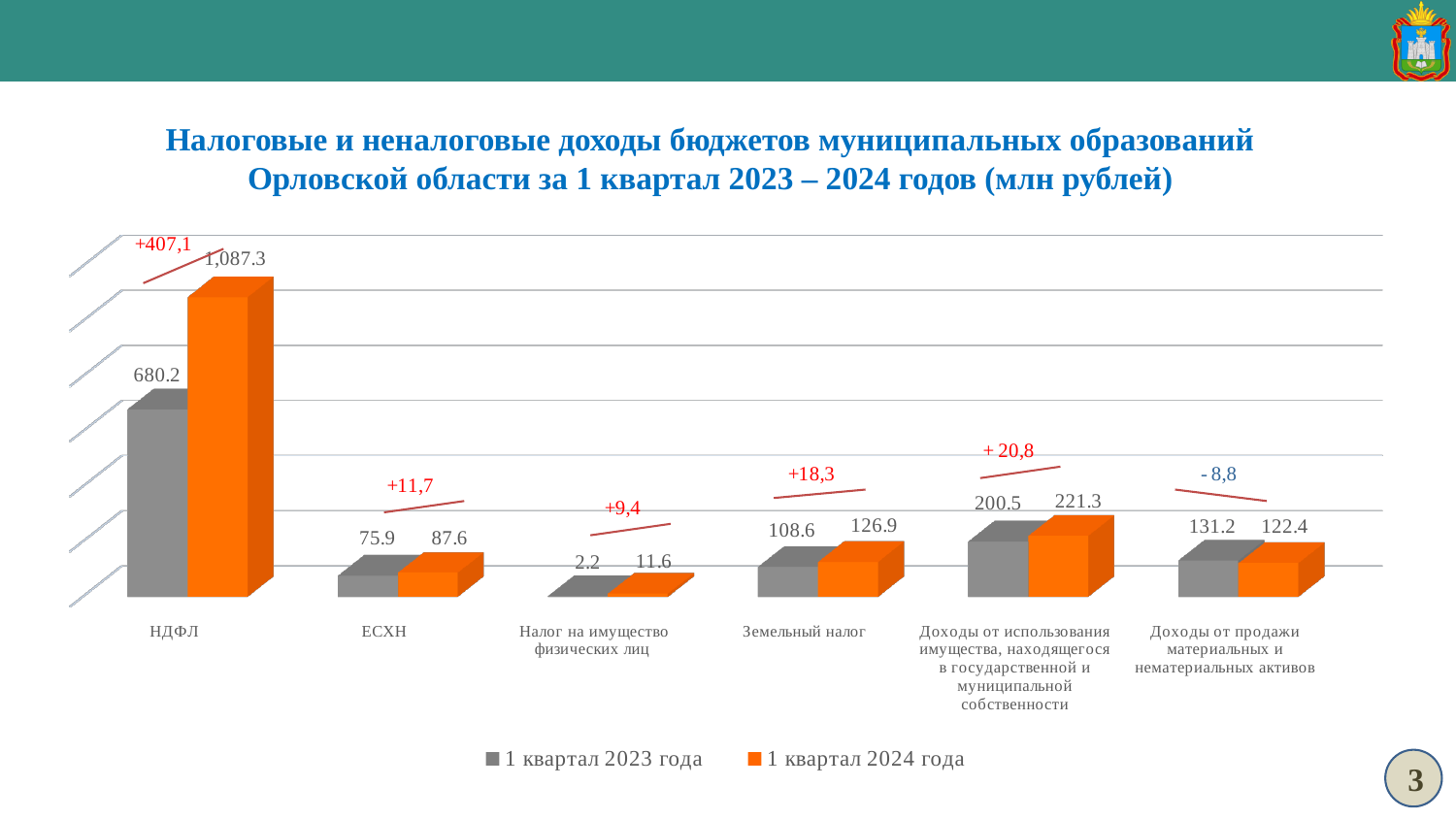
Which colour represents 1 квартал 2024 года in the chart? Orange For Доходы от продажи материальных и нематериальных активов, which is larger: the 1 квартал 2023 года value or the 1 квартал 2024 года value? 1 квартал 2023 года What is the value for Налог на имущество физических лиц in 1 квартал 2023 года? 2.2 What is the value for НДФЛ in 1 квартал 2024 года? 1,087.3 How many series does the legend list? 2 What kind of chart is shown on the slide? Bar chart What is the difference between the 1 квартал 2024 года and 1 квартал 2023 года values for ЕСХН? 11.7 Which category has the highest value in 1 квартал 2024 года? НДФЛ Which category has the lowest value in 1 квартал 2023 года? Налог на имущество физических лиц What is the value for Земельный налог in 1 квартал 2024 года? 126.9 How many categories are shown on the x axis of the chart? 6 What is the value for НДФЛ in 1 квартал 2023 года? 680.2